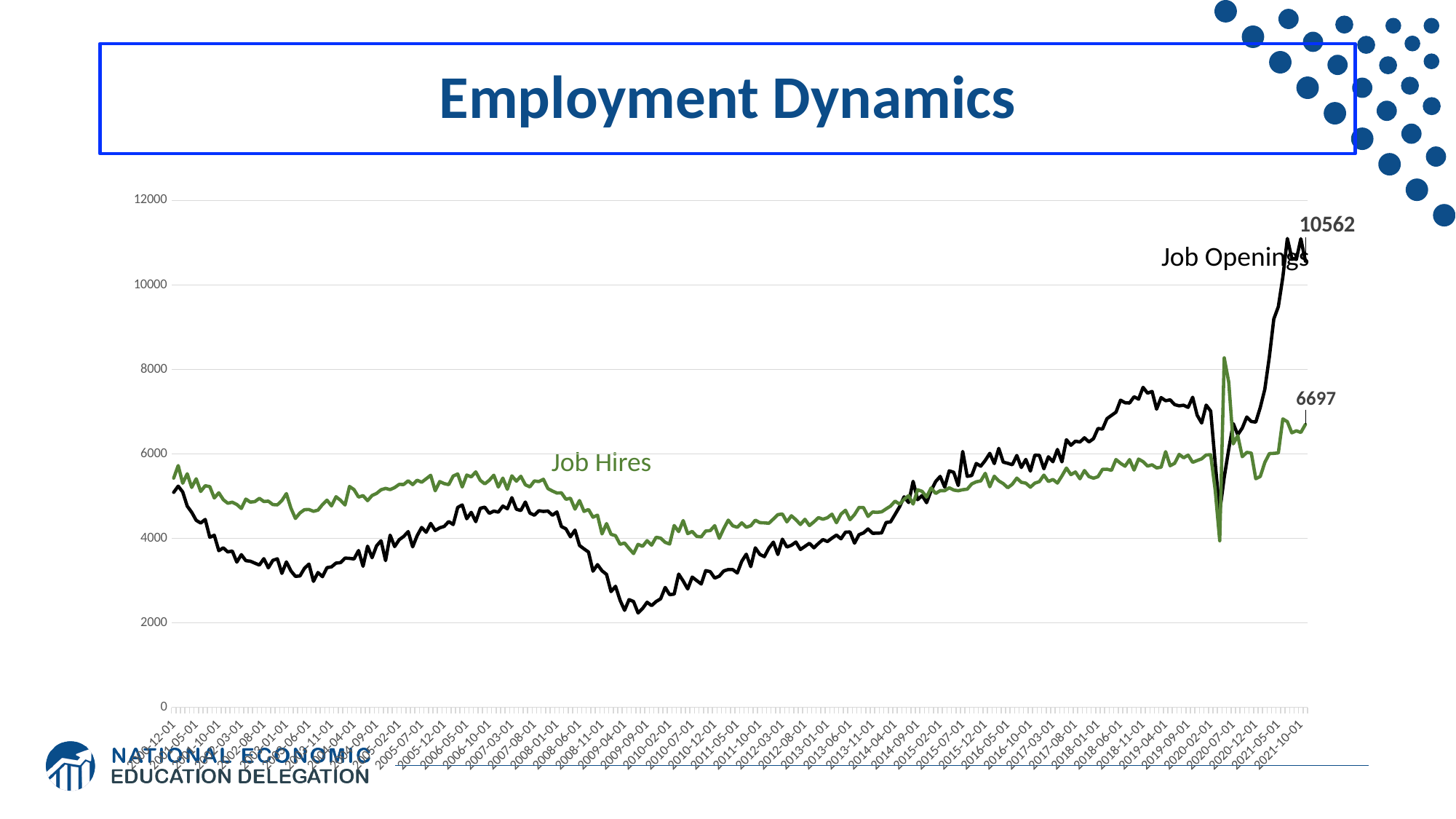
What colour is the Job Hires line? green What is the difference between the final labelled values of Job Openings and Job Hires? 3865 Is the value of Job Openings at 2018-11-01 greater or less than 6000? greater What kind of chart is shown on the slide? line chart Is the value of Job Openings at 2009-09-01 greater or less than 4000? less What is the final labelled value of the Job Hires series? 6697 Is the value of Job Hires at 2005-12-01 greater or less than 4000? greater At the end of the series, which is larger: Job Openings or Job Hires? Job Openings Does the Job Openings series rise or fall between 2008-01-01 and 2009-09-01? fall What is the title of the chart? Employment Dynamics What is the final labelled value of the Job Openings series? 10562 How many data series are plotted on the chart? 2